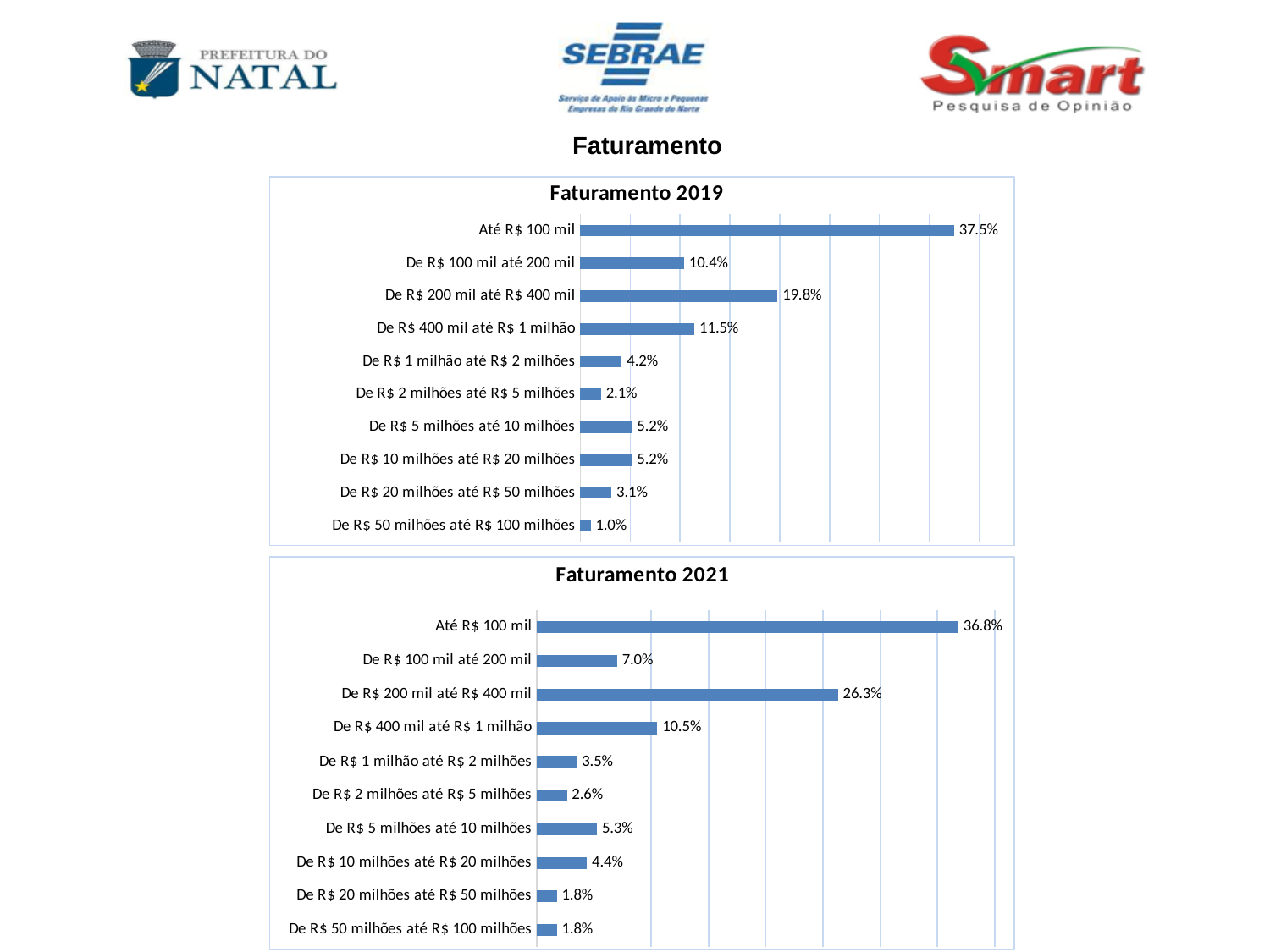
In the 'Faturamento 2021' chart, which category has the highest value? Até R$ 100 mil What is the title of the bottom chart on the slide? Faturamento 2021 How many categories does the 'Faturamento 2021' chart show? 10 In the 'Faturamento 2019' chart, which is larger: 'De R$ 1 milhão até R$ 2 milhões' or 'De R$ 5 milhões até 10 milhões'? De R$ 5 milhões até 10 milhões In the 'Faturamento 2019' chart, which category has the highest value? Até R$ 100 mil In the 'Faturamento 2019' chart, what is the difference between 'De R$ 400 mil até R$ 1 milhão' and 'De R$ 100 mil até 200 mil'? 1.1% In the 'Faturamento 2021' chart, what is the value for 'De R$ 400 mil até R$ 1 milhão'? 10.5% In the 'Faturamento 2019' chart, which category has the lowest value? De R$ 50 milhões até R$ 100 milhões What kind of chart is 'Faturamento 2019'? Bar chart In the 'Faturamento 2021' chart, which is larger: 'De R$ 100 mil até 200 mil' or 'De R$ 5 milhões até 10 milhões'? De R$ 100 mil até 200 mil In the 'Faturamento 2019' chart, what is the value for 'De R$ 200 mil até R$ 400 mil'? 19.8% In the 'Faturamento 2021' chart, what is the difference between 'Até R$ 100 mil' and 'De R$ 200 mil até R$ 400 mil'? 10.5%